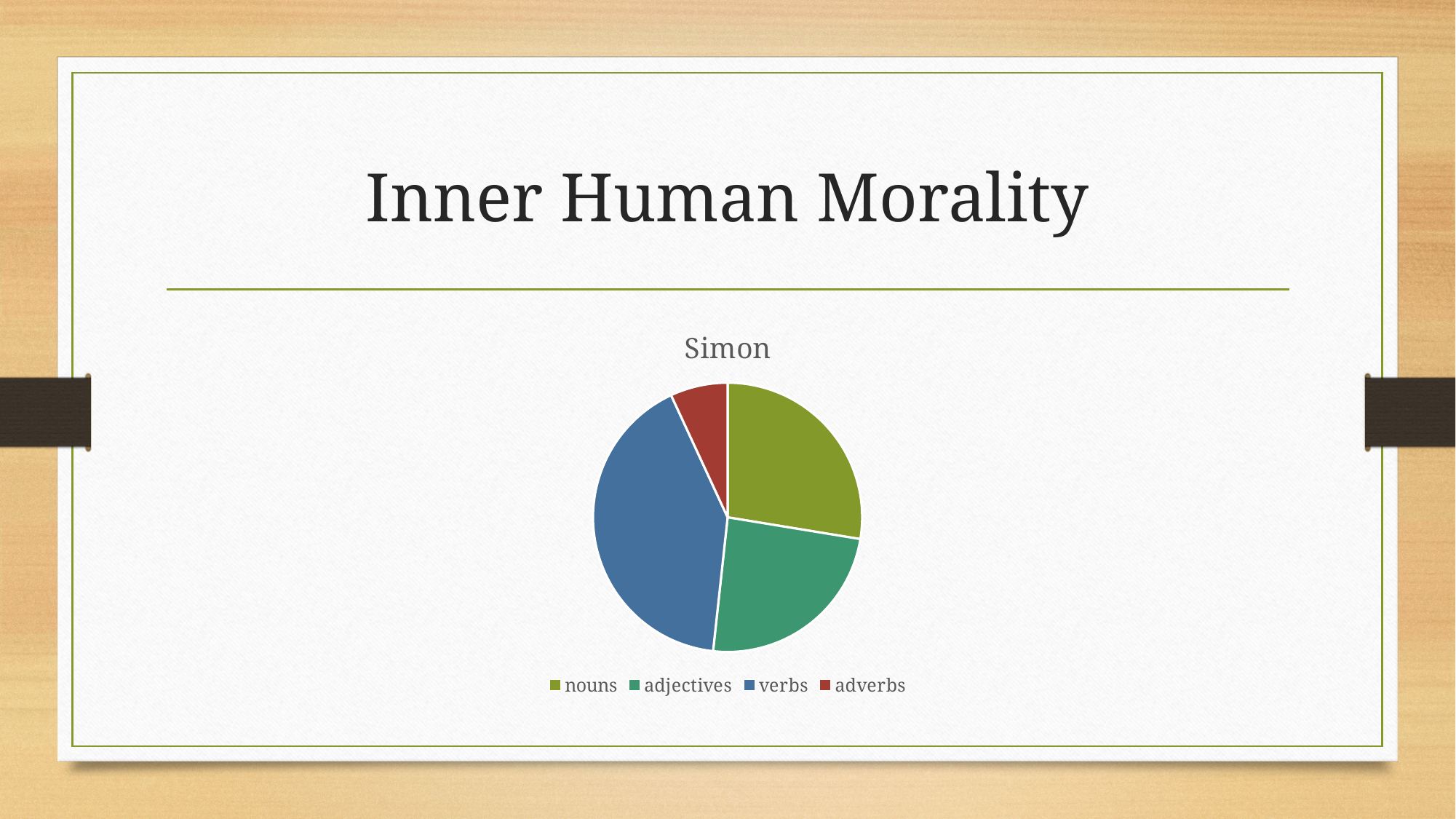
What colour is the slice for verbs? blue Which slice is larger, verbs or adverbs? verbs Which slice is larger, verbs or adjectives? verbs How many slices does the pie chart have? 4 What kind of chart is shown on the slide? pie chart Which slice is larger, nouns or adverbs? nouns Which category has the smallest slice of the pie? adverbs What is the title of the chart? Simon How many entries does the legend list? 4 Which category has the largest slice of the pie? verbs